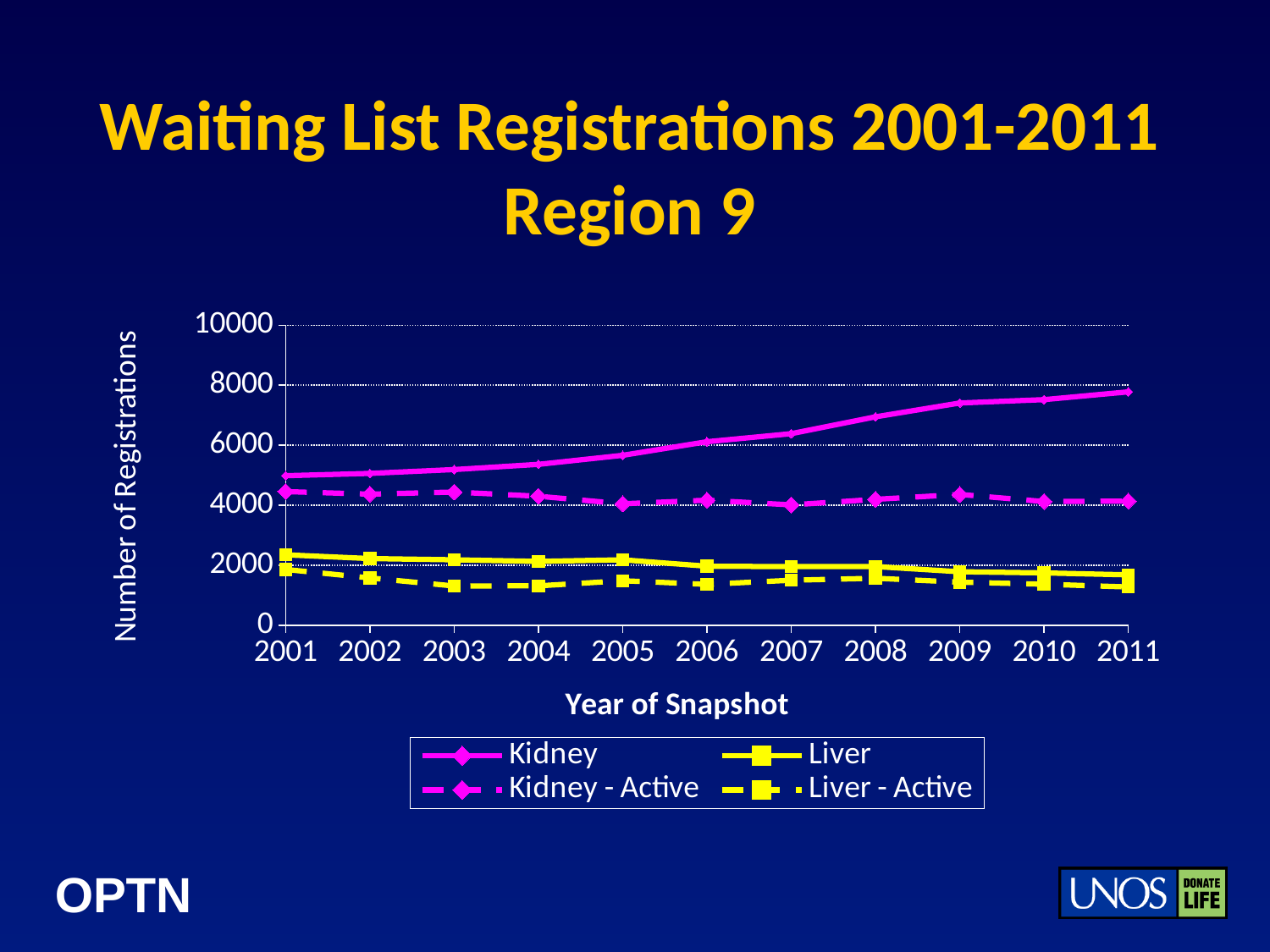
How many years are plotted along the x axis? 11 What kind of chart is shown on the slide? line chart Does the Kidney series rise or fall from 2001 to 2011? rise Which series has the highest value in 2011? Kidney In 2011, which is larger: the Kidney value or the Liver value? Kidney Is the Kidney - Active value for 2011 greater or less than 6000? less Which series has the lowest value in 2011? Liver - Active What is the label of the x axis? Year of Snapshot Is the Liver - Active value for 2011 greater or less than 2000? less How many series does the legend list? 4 Is the Kidney value for 2011 greater or less than 6000? greater